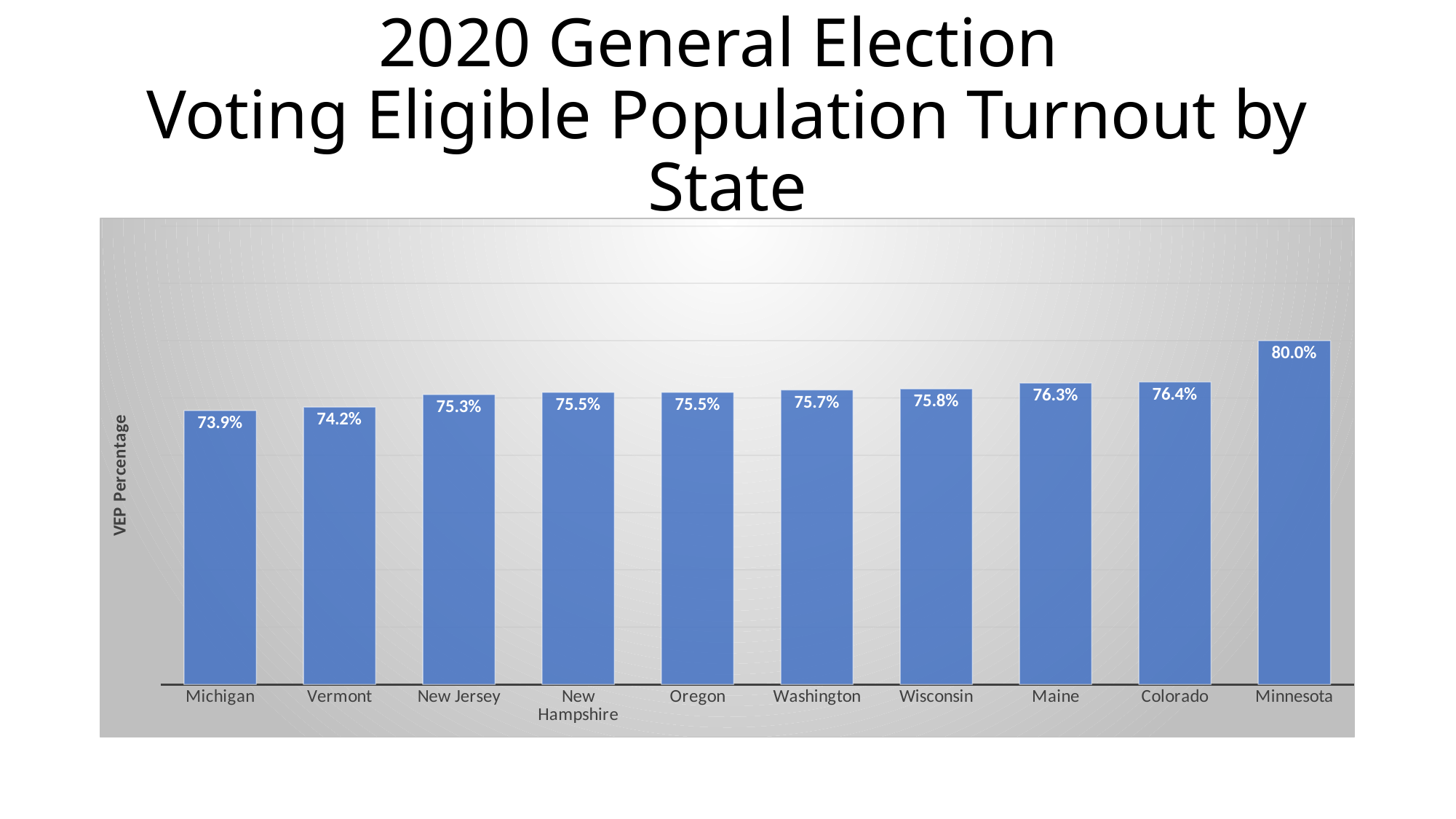
What is the VEP turnout percentage for Colorado? 76.4% What is the VEP turnout percentage for Wisconsin? 75.8% Which state has the lowest VEP turnout percentage? Michigan Which state has the highest VEP turnout percentage? Minnesota What is the VEP turnout percentage for Michigan? 73.9% How many states are shown in the chart? 10 Which has a higher VEP turnout percentage, Colorado or New Jersey? Colorado What is the label on the vertical axis of the chart? VEP Percentage What is the VEP turnout percentage for Minnesota? 80.0% What is the difference in VEP turnout percentage between Maine and Vermont? 2.1% What is the difference in VEP turnout percentage between Minnesota and Michigan? 6.1% What kind of chart is shown on the slide? Bar chart